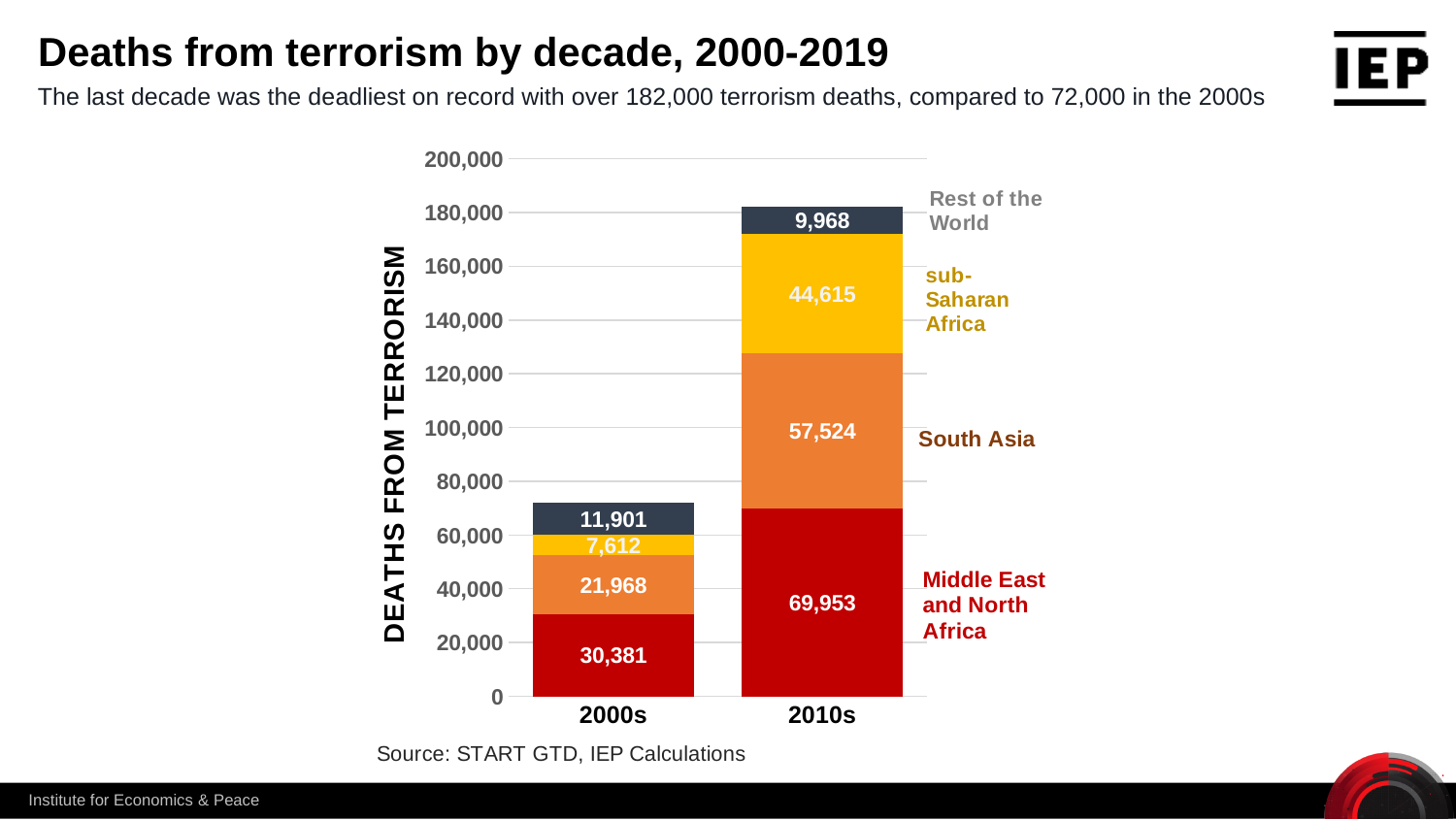
What is the total of the 2000s stacked bar? 71,862 Which region has the largest segment in the 2010s bar? Middle East and North Africa What is the difference between the Middle East and North Africa values for the 2010s and the 2000s? 39,572 What is the value for Middle East and North Africa in the 2010s bar? 69,953 What is the value for South Asia in the 2000s bar? 21,968 How many regions (series) are shown in the stacked bars? 4 What type of chart is shown on the slide? Stacked bar chart What is the value for Rest of the World in the 2000s bar? 11,901 What is the total of the 2010s stacked bar? 182,060 What is the value for sub-Saharan Africa in the 2010s bar? 44,615 Which is larger: Rest of the World in the 2000s or Rest of the World in the 2010s? Rest of the World in the 2000s Which region has the smallest segment in the 2000s bar? sub-Saharan Africa